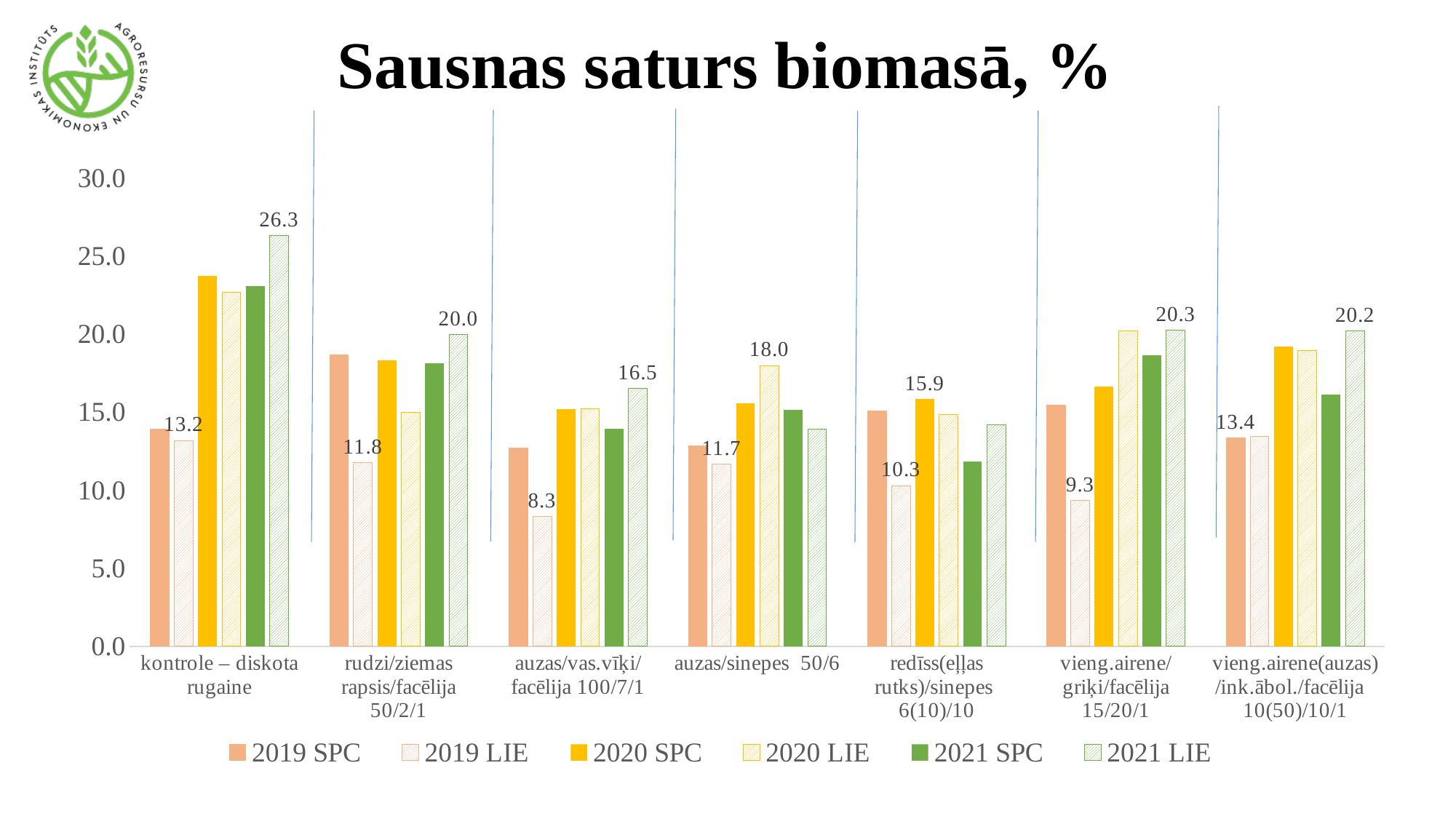
In the 'rudzi/ziemas rapsis/facēlija 50/2/1' category, how much higher is the 2021 LIE value than the 2019 LIE value? 8.2 Which category has the lowest 2019 LIE value? auzas/vas.vīķi/facēlija 100/7/1 What is the value for 2021 LIE in the 'kontrole – diskota rugaine' category? 26.3 What is the value for 2020 SPC in the 'redīss(eļļas rutks)/sinepes 6(10)/10' category? 15.9 In the 'kontrole – diskota rugaine' category, what is the difference between the 2021 LIE value and the 2019 LIE value? 13.1 What is the value for 2019 LIE in the 'auzas/vas.vīķi/facēlija 100/7/1' category? 8.3 How many series does the legend list? 6 What is the value for 2020 LIE in the 'auzas/sinepes 50/6' category? 18.0 How many categories are shown on the x axis? 7 Which series has the highest value in the 'kontrole – diskota rugaine' category? 2021 LIE Is the 2020 SPC value for 'kontrole – diskota rugaine' greater or less than 20.0? greater Is the 2021 LIE value larger for 'kontrole – diskota rugaine' or for 'rudzi/ziemas rapsis/facēlija 50/2/1'? kontrole – diskota rugaine